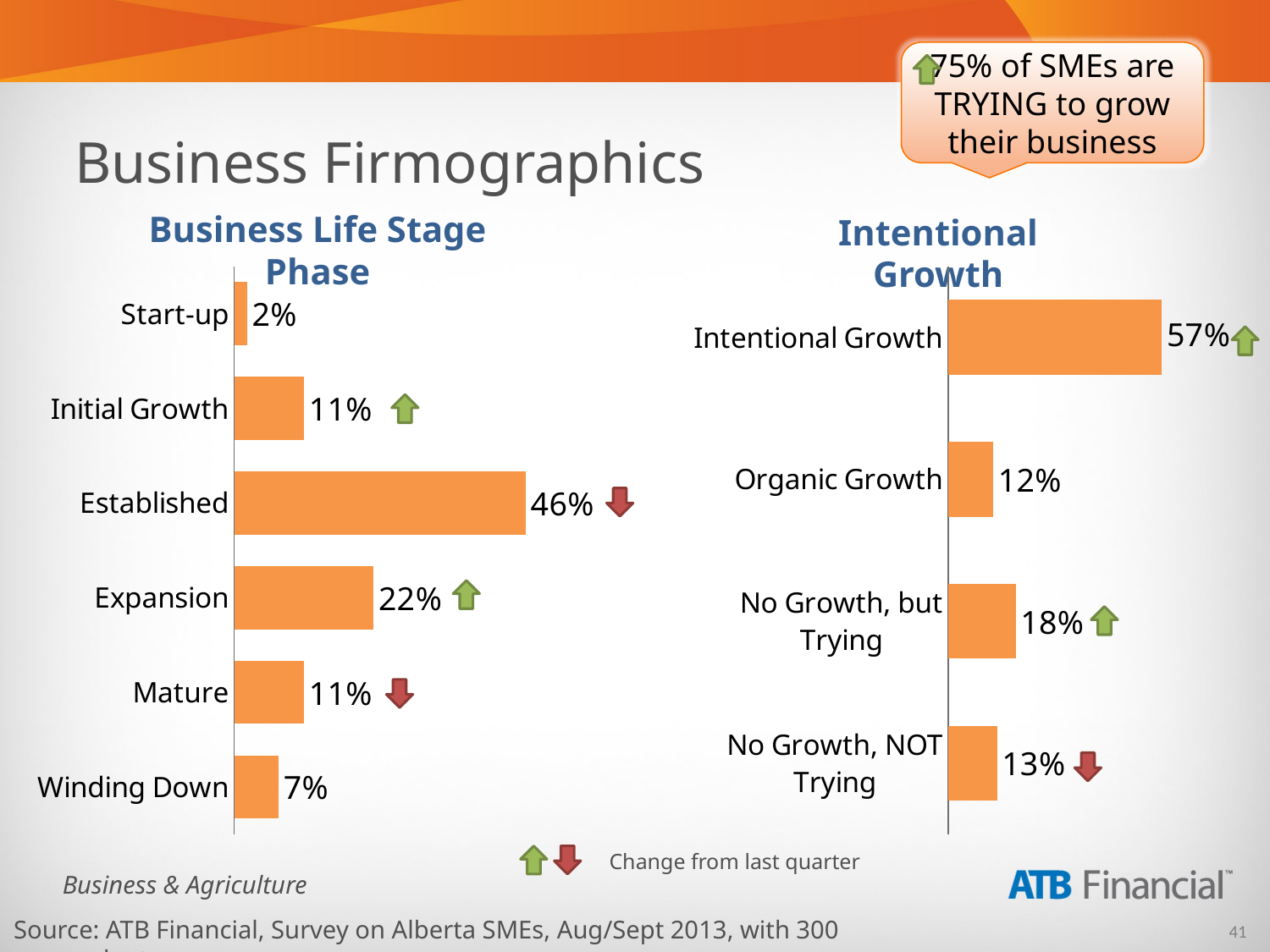
In the Business Life Stage Phase chart, which category has the lowest value? Start-up In the Business Life Stage Phase chart, which category has the highest value? Established In the Intentional Growth chart, what is the value for No Growth, but Trying? 18% In the Intentional Growth chart, which is larger: Organic Growth or No Growth, NOT Trying? No Growth, NOT Trying In the Business Life Stage Phase chart, what is the value for Established? 46% In the Business Life Stage Phase chart, what is the value for Expansion? 22% In the Intentional Growth chart, which category has the highest value? Intentional Growth In the Business Life Stage Phase chart, how many categories are shown? 6 What kind of chart is the Intentional Growth chart? Bar chart In the Business Life Stage Phase chart, what is the difference between Established and Expansion? 24% In the Business Life Stage Phase chart, what is the value for Winding Down? 7% In the Intentional Growth chart, what is the difference between Intentional Growth and Organic Growth? 45%